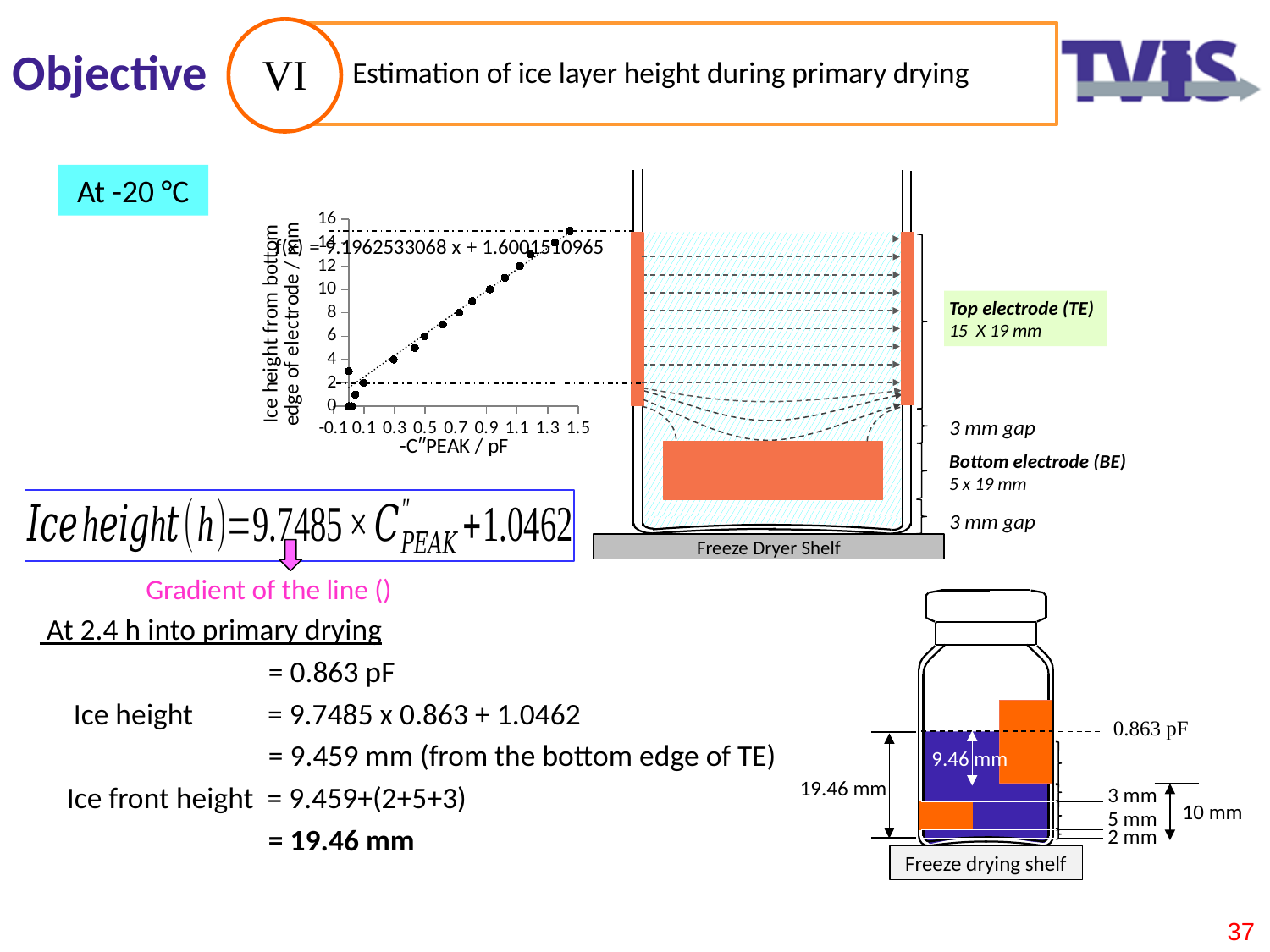
Is the ice height for the plotted point near 1.1 pF greater or less than 10 mm? greater What is the highest tick value shown on the y axis of the chart? 16 What is the trendline equation printed on the chart? f(x) = 9.1962533068 x + 1.6001510965 What is the lowest tick value shown on the x axis of the chart? -0.1 What kind of chart is shown on the slide? scatter chart What is the label of the x axis of the chart? -C″PEAK / pF Is the ice height for the plotted point near 0.9 pF greater or less than 8 mm? greater Which plotted point has the highest ice height: the one near 1.4 pF or the one near 0.5 pF? the one near 1.4 pF Is the ice height for the rightmost plotted point (near 1.4 pF) greater or less than 14 mm? greater Do the plotted ice height values rise or fall as -C″PEAK increases along the x axis? rise